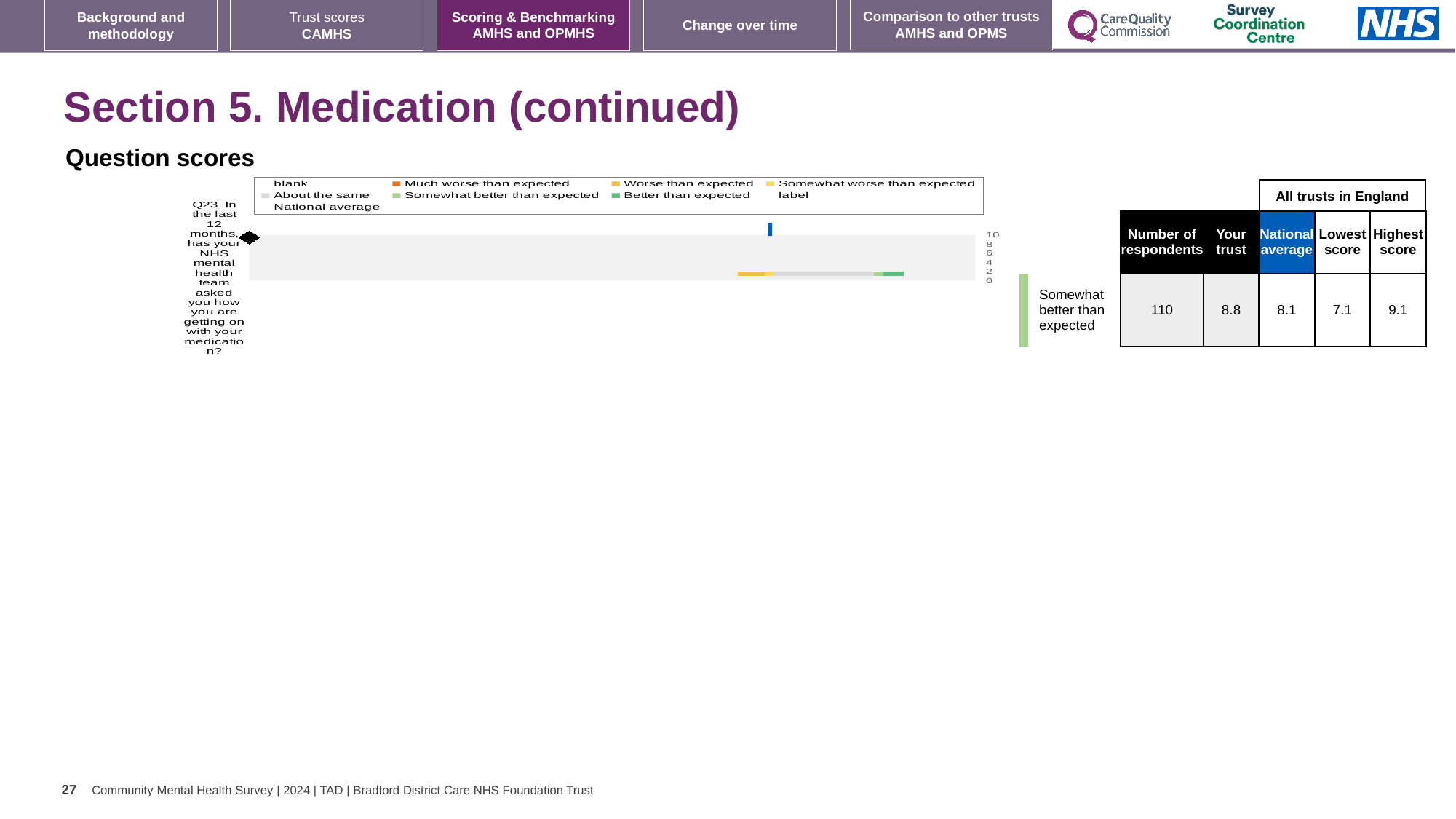
How many entries does the chart legend list? 9 In the table beside the chart, what is the lowest score among all trusts in England for Q23? 7.1 Which question is plotted in the chart? Q23. In the last 12 months, has your NHS mental health team asked you how you are getting on with your medication? In the table beside the chart, what is the number of respondents for Q23? 110 According to the label beside the chart, how does the trust's score for Q23 compare with what was expected? Somewhat better than expected In the table beside the chart, what is the national average score for Q23? 8.1 In the table beside the chart, what is the highest score among all trusts in England for Q23? 9.1 What is the highest value shown on the chart's axis? 10 In the table beside the chart, what is the 'Your trust' score for Q23? 8.8 What kind of chart is shown under 'Question scores'? bar chart In the table beside the chart, which is larger for Q23: the 'Your trust' score or the national average? Your trust How many question categories are plotted in the chart? 1